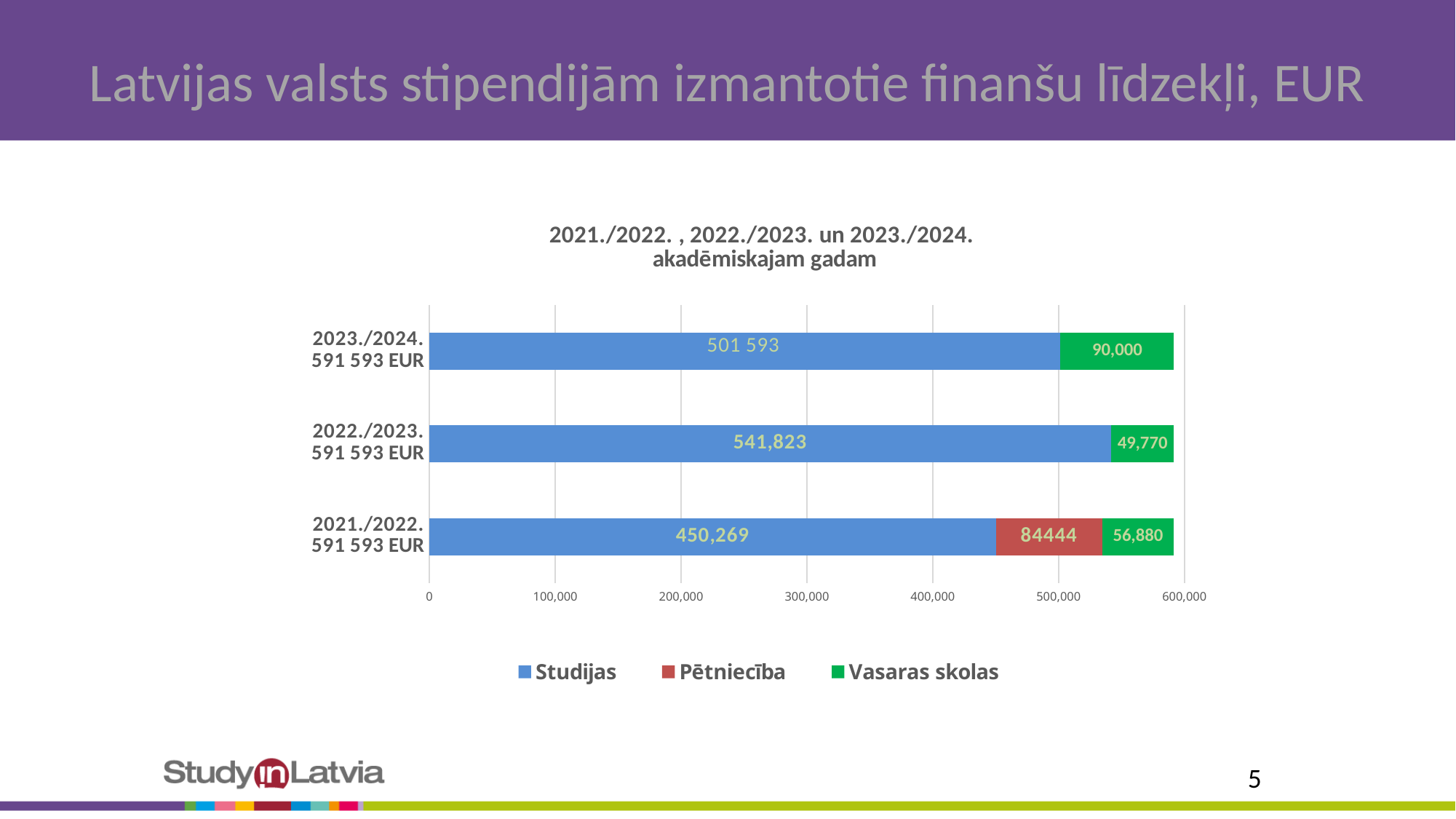
Which series is shown in red in the legend? Pētniecība What is the Vasaras skolas value for 2022./2023.? 49,770 What type of chart is shown on the slide? stacked bar chart Which is larger: the Vasaras skolas value for 2023./2024. or for 2021./2022.? 2023./2024. What is the Pētniecība value for 2021./2022.? 84444 Which academic year has the lowest Vasaras skolas value? 2022./2023. What is the total of the stacked bar for 2021./2022.? 591 593 EUR What is the difference between the Studijas values for 2022./2023. and 2021./2022.? 91,554 How many academic years (categories) are plotted on the chart? 3 Which academic year has the highest Studijas value? 2022./2023. How many series does the legend list? 3 What is the Studijas value for 2023./2024.? 501 593